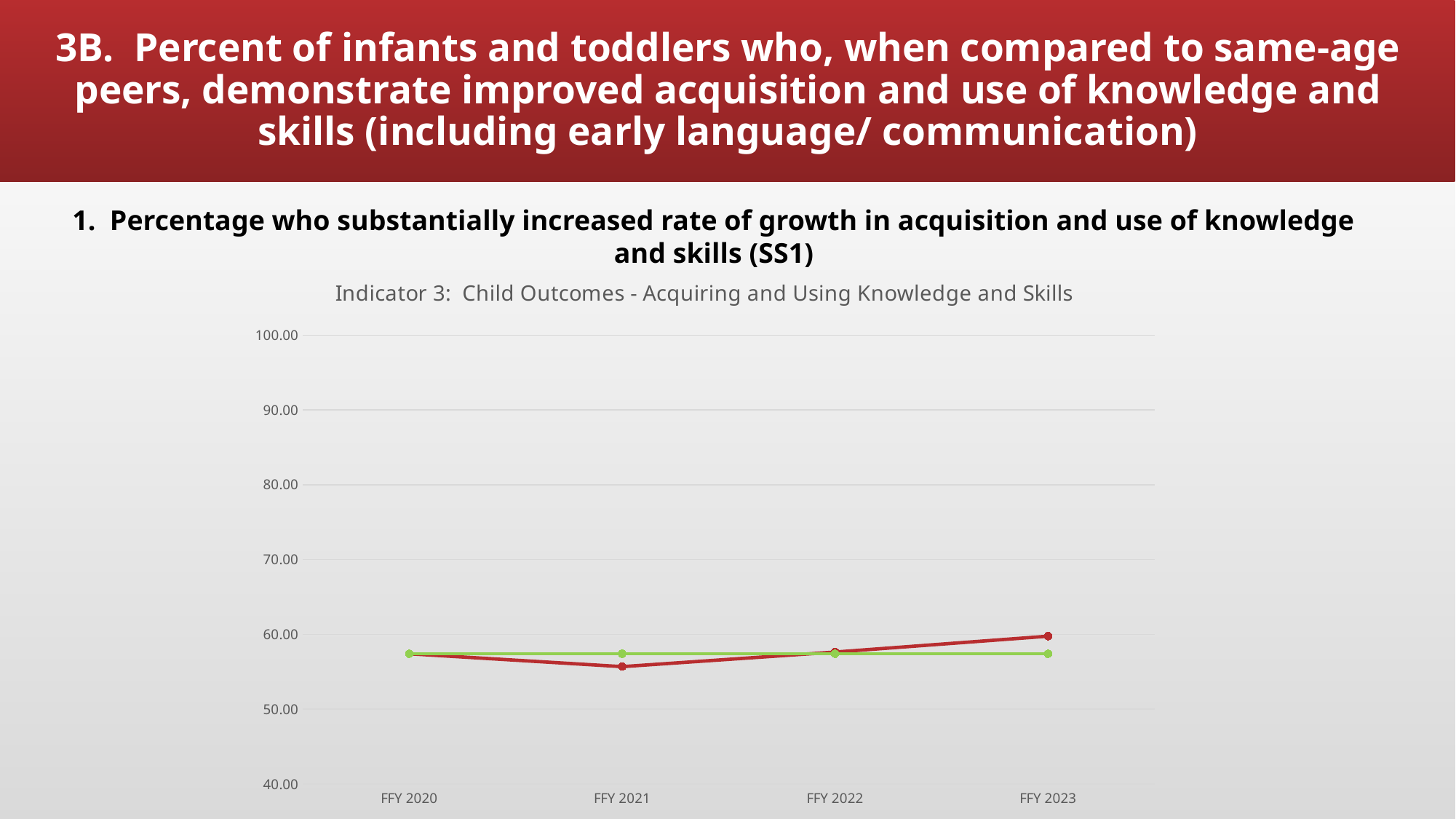
Does the red line rise or fall from FFY 2021 to FFY 2023? Rises In which fiscal year does the red line reach its lowest value? FFY 2021 At FFY 2023, which line is higher, the red line or the green line? Red line Is the value of the red line at FFY 2021 greater or less than 60.00? less How many fiscal years are shown on the x axis of the chart? 4 What kind of chart is shown on the slide? Line chart In which fiscal year does the red line reach its highest value? FFY 2023 How many lines are plotted on the chart? 2 At FFY 2021, which line is higher, the red line or the green line? Green line Is the value of the red line at FFY 2023 greater or less than 70.00? less What is the title of the chart? Indicator 3: Child Outcomes - Acquiring and Using Knowledge and Skills Is the value of the green line at FFY 2020 greater or less than 50.00? greater